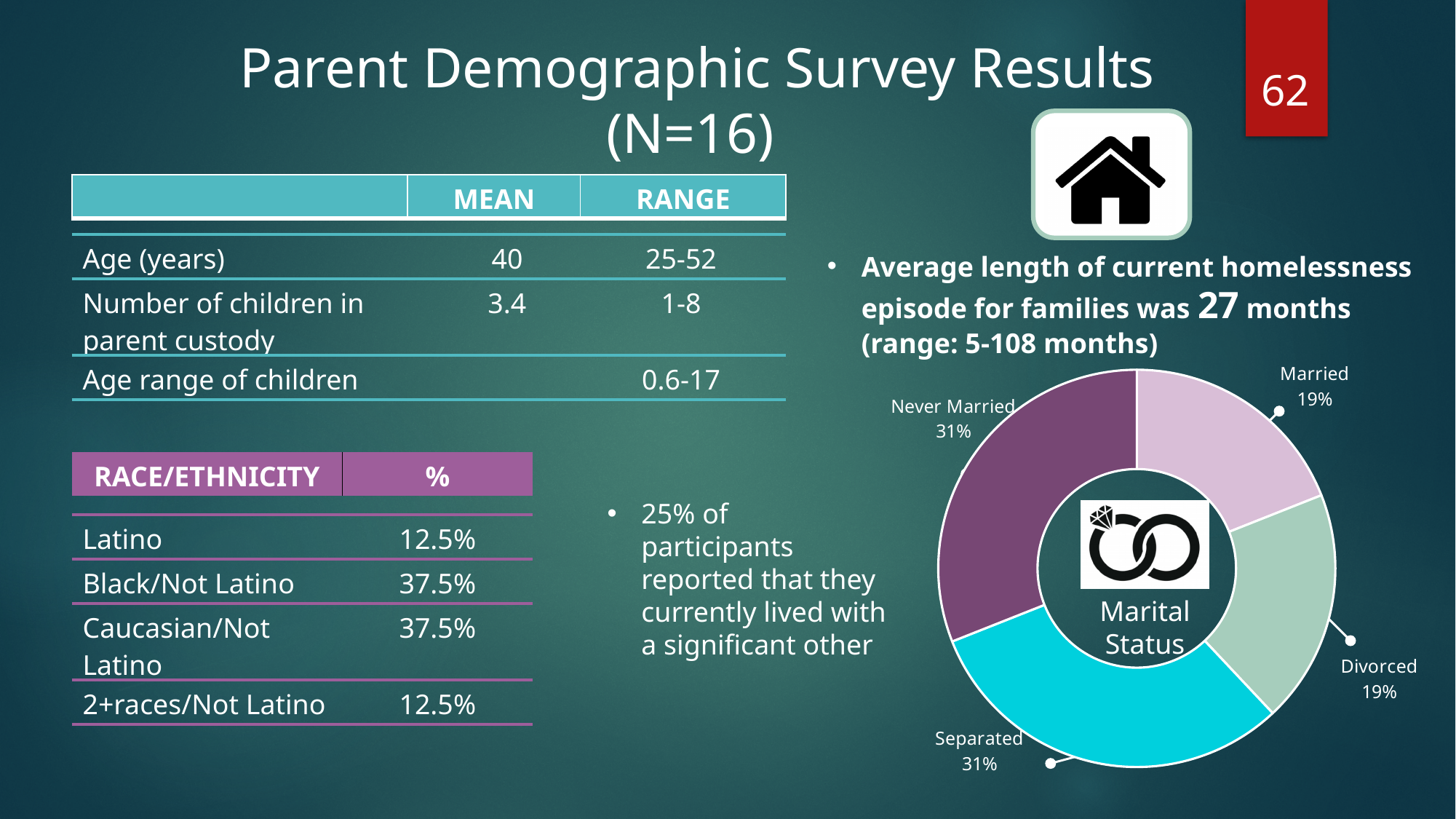
What is the title shown in the centre of the doughnut chart? Marital Status In the Marital Status chart, what percentage of participants were Married? 19% In the Marital Status chart, which category is shown in the bright cyan slice? Separated In the Marital Status chart, which is larger: the share for Never Married or the share for Divorced? Never Married How many categories are shown in the Marital Status chart? 4 In the Marital Status chart, what percentage of participants were Separated? 31% In the Marital Status chart, what percentage of participants were Never Married? 31% What kind of chart is the Marital Status chart? Doughnut (pie) chart In the Marital Status chart, what percentage of participants were Divorced? 19% In the Marital Status chart, what is the combined percentage of Married and Divorced participants? 38% In the Marital Status chart, which is larger: the share for Separated or the share for Married? Separated In the Marital Status chart, what is the difference in percentage points between Never Married and Married? 12%